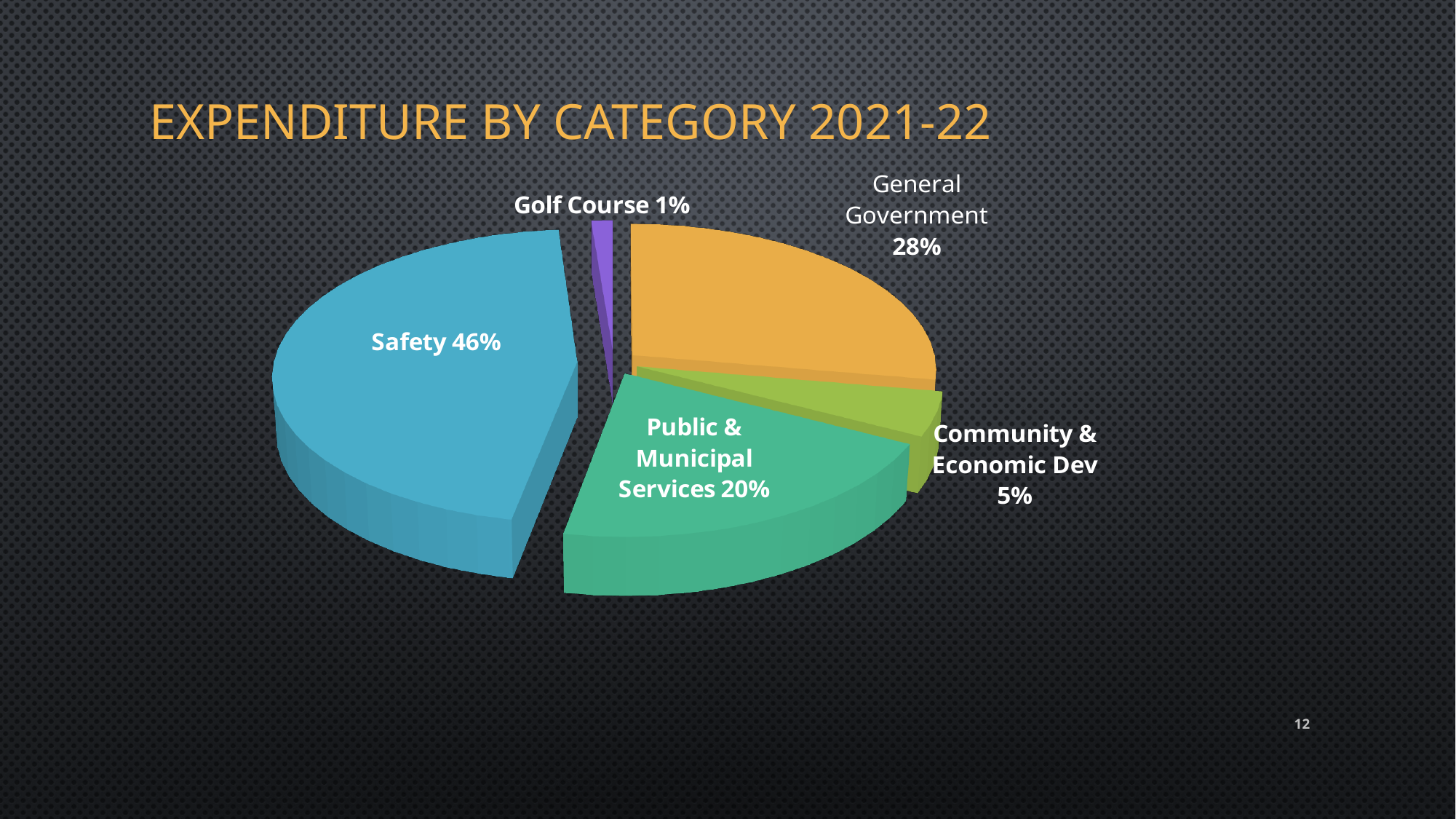
What type of chart is shown on the slide? Pie chart What is the share for Public & Municipal Services? 20% Which category has the smallest share of expenditure? Golf Course What percentage of expenditure goes to General Government? 28% What share of expenditure does Safety account for? 46% What is the title of the chart? Expenditure by Category 2021-22 What is the difference in percentage points between Safety and General Government? 18 Which category has the largest share of expenditure? Safety How many categories are shown in the pie chart? 5 Which is larger, Public & Municipal Services or Community & Economic Dev? Public & Municipal Services What share of expenditure does the Golf Course represent? 1% What percentage is shown for Community & Economic Dev? 5%